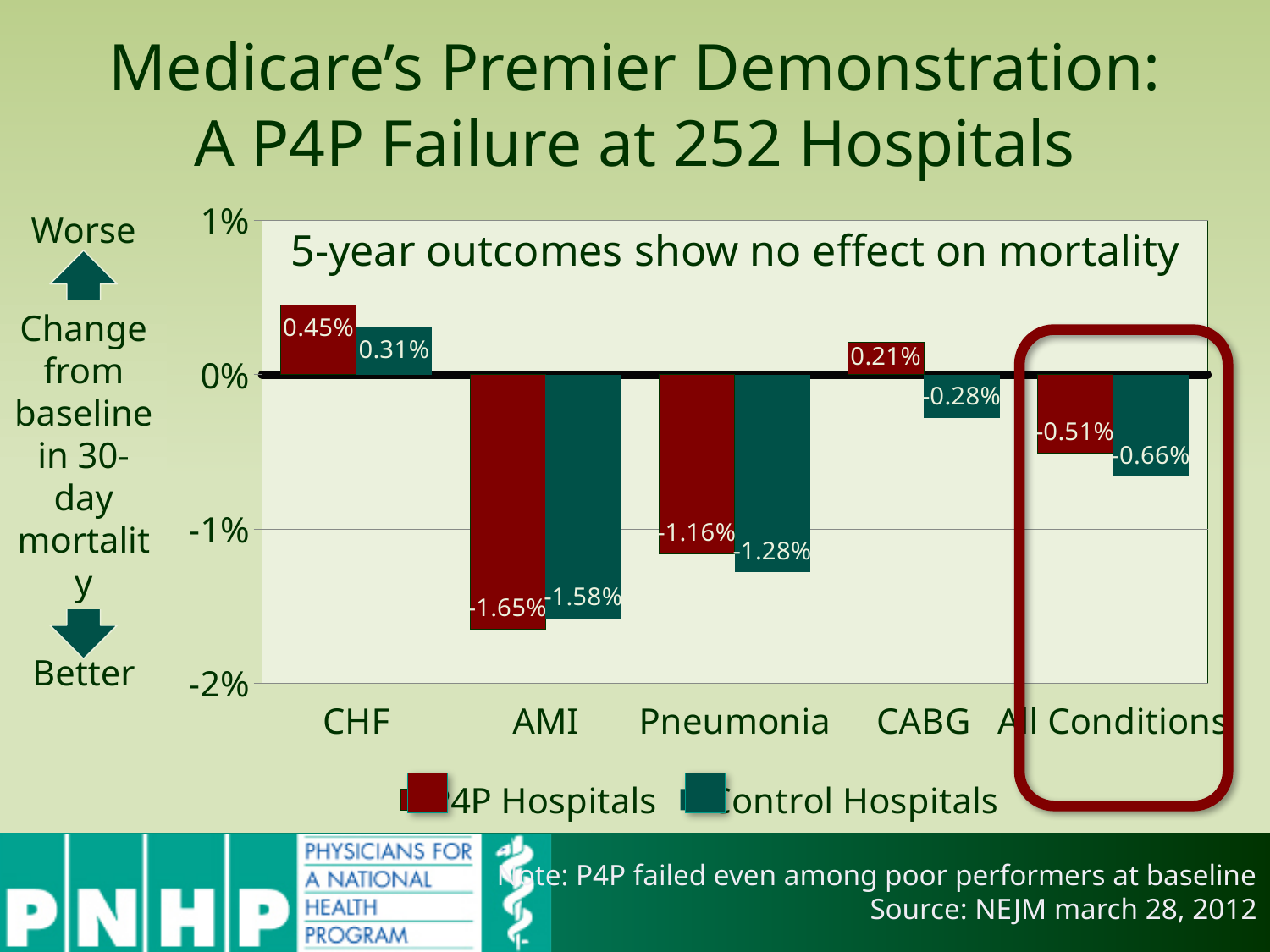
What is the difference between the P4P Hospitals and Control Hospitals values in the Pneumonia category? 0.12% How many categories are shown on the x axis? 5 Which category has the lowest value for P4P Hospitals? AMI What kind of chart is shown on the slide? Bar chart What is the value for Control Hospitals in the AMI category? -1.58% In the CABG category, which is larger: the P4P Hospitals value or the Control Hospitals value? P4P Hospitals Which category has the highest value for Control Hospitals? CHF How many series does the legend list? 2 What is the value for Control Hospitals in the CABG category? -0.28% What is the value for P4P Hospitals in the All Conditions category? -0.51% Is the value for Control Hospitals in the Pneumonia category greater or less than -1%? less What is the value for P4P Hospitals in the CHF category? 0.45%